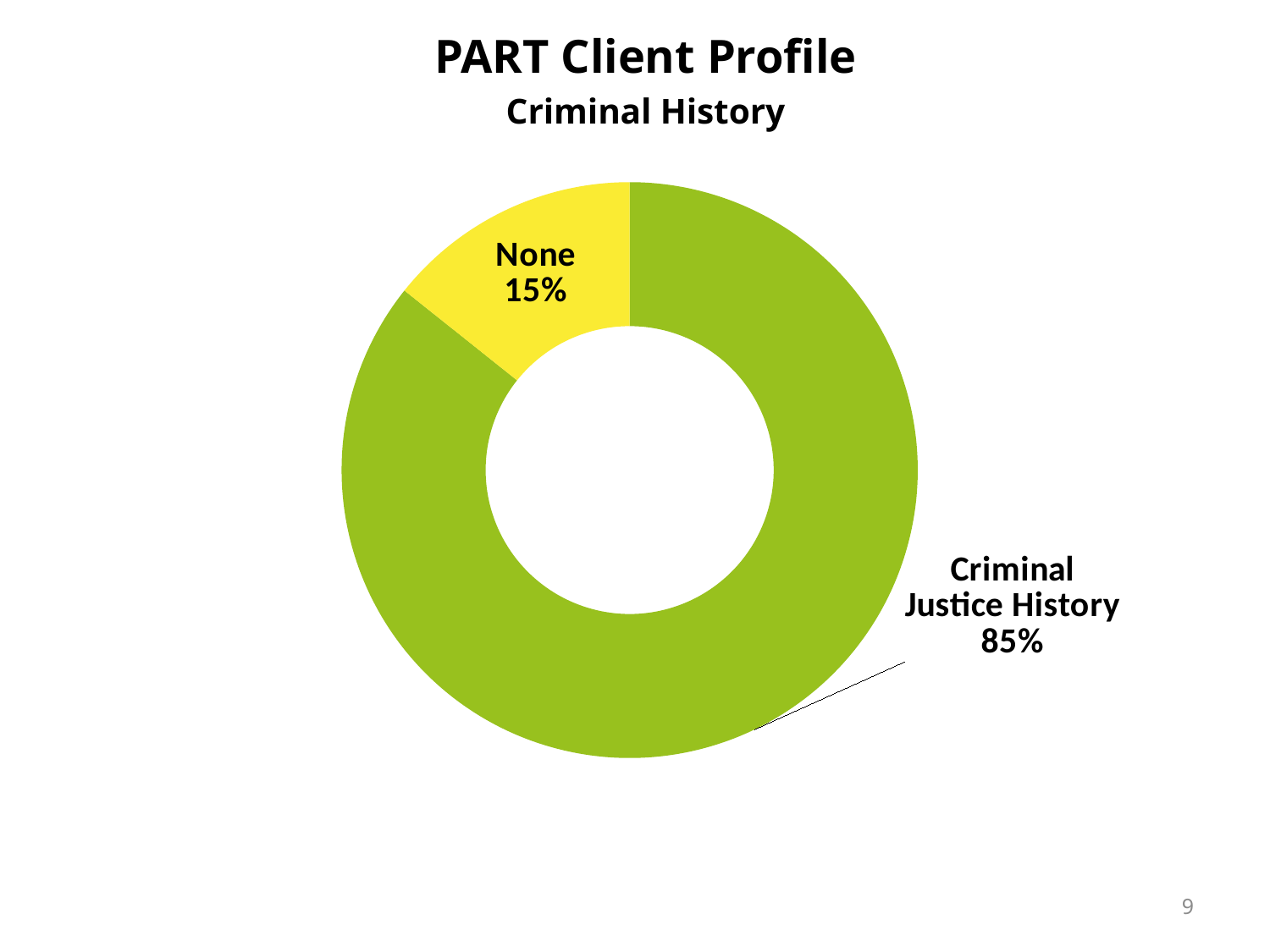
What percentage of PART clients have no criminal history (None)? 15% What is the title of the chart? PART Client Profile Criminal History What is the difference in percentage points between Criminal Justice History and None? 70 What share of the pie does the None slice represent? 15% How many categories are shown in the chart? 2 What colour is the None slice? Yellow What kind of chart is shown on the slide? Pie chart (doughnut) Which category has the largest share of the chart? Criminal Justice History Which category has the smallest share of the chart? None Which is larger: the share for Criminal Justice History or the share for None? Criminal Justice History What percentage of PART clients have a Criminal Justice History? 85%